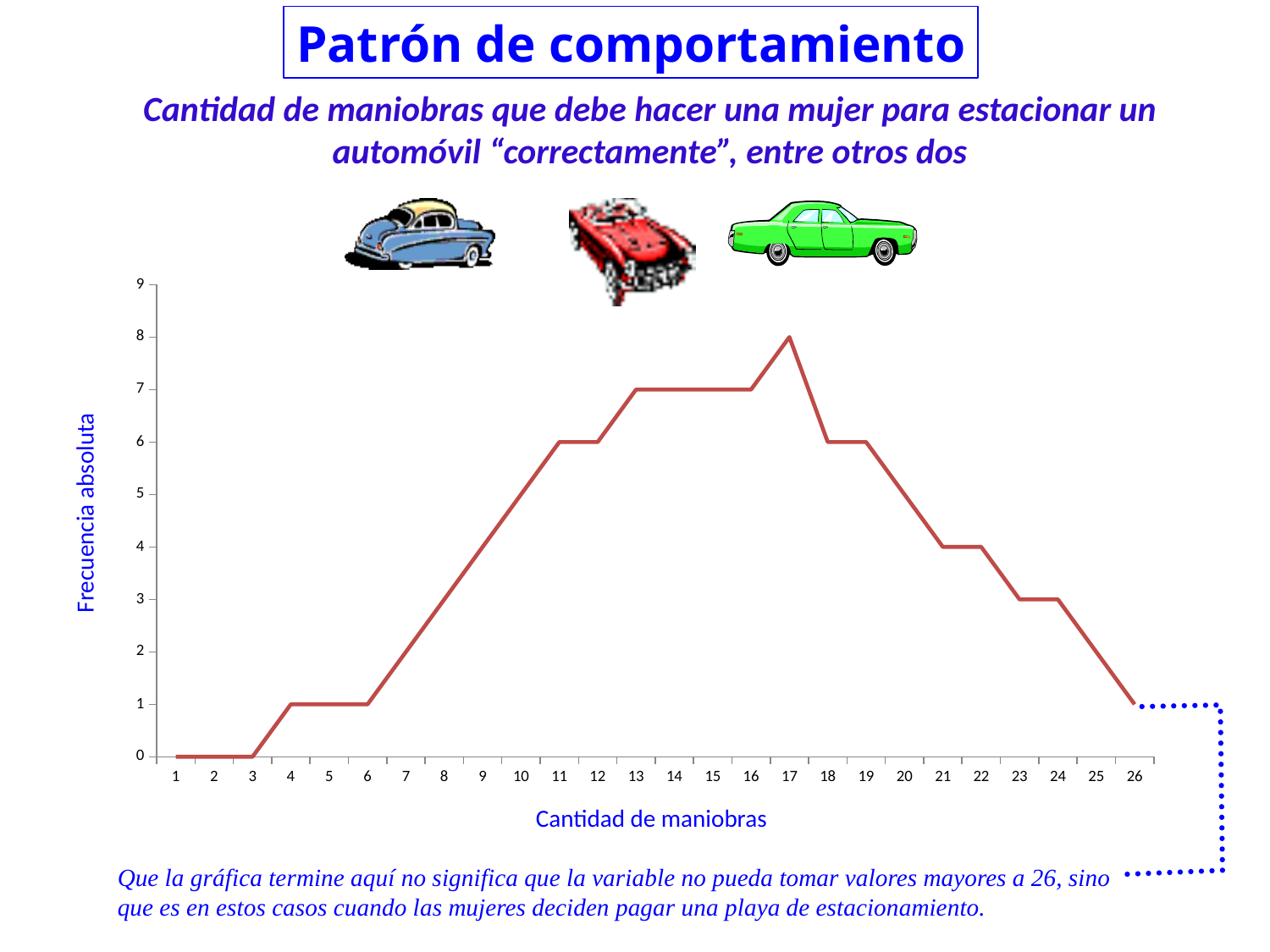
What is the absolute frequency for 13 maneuvers? 7 What kind of chart is shown on the slide? line chart At which number of maneuvers (Cantidad de maniobras) does the absolute frequency reach its highest value? 17 What is the label of the x axis? Cantidad de maniobras How many values of Cantidad de maniobras are shown on the x axis? 26 What is the absolute frequency for 4 maneuvers? 1 What is the label of the y axis? Frecuencia absoluta Does the absolute frequency rise or fall between 17 and 26 maneuvers? fall What is the highest absolute frequency shown on the chart? 8 What is the difference in absolute frequency between 17 maneuvers and 18 maneuvers? 2 Which has a higher absolute frequency, 11 maneuvers or 21 maneuvers? 11 maneuvers What is the absolute frequency for 26 maneuvers? 1